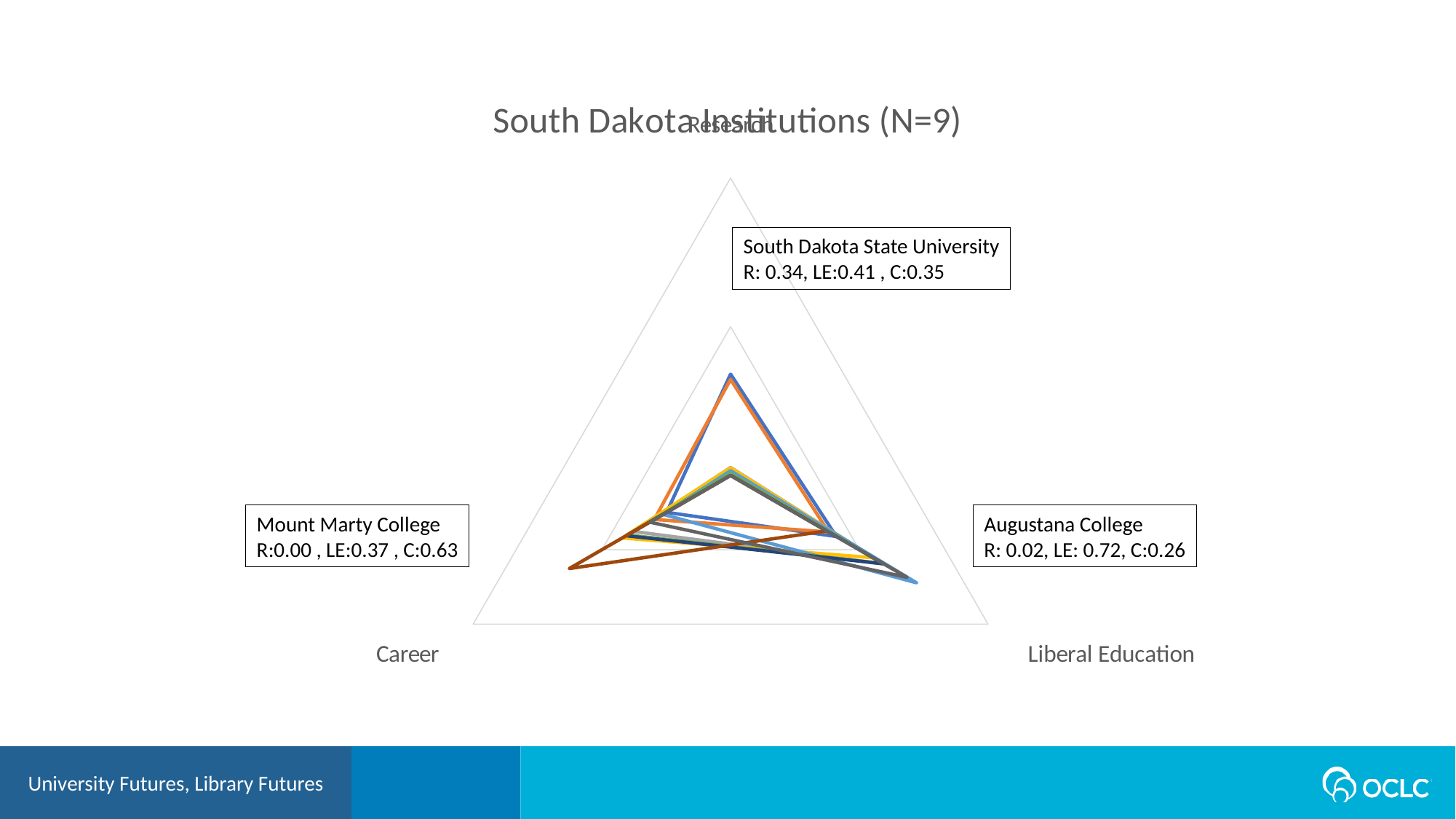
What is the Career (C) value shown for Mount Marty College? 0.63 Which is larger: the Liberal Education (LE) value for South Dakota State University or for Mount Marty College? South Dakota State University What is the Career (C) value shown for Augustana College? 0.26 Which of the three labelled institutions has the highest Liberal Education (LE) value? Augustana College What is the Liberal Education (LE) value shown for Augustana College? 0.72 What is the Research (R) value shown for Mount Marty College? 0.00 What is the Research (R) value shown for South Dakota State University? 0.34 What is the difference between the Career (C) values of Mount Marty College and Augustana College? 0.37 Which of the three labelled institutions has the lowest Research (R) value? Mount Marty College What kind of chart is shown on the slide? Radar chart How many institutions does the chart title say are included (N)? 9 How many axes (dimensions) does the chart have? 3